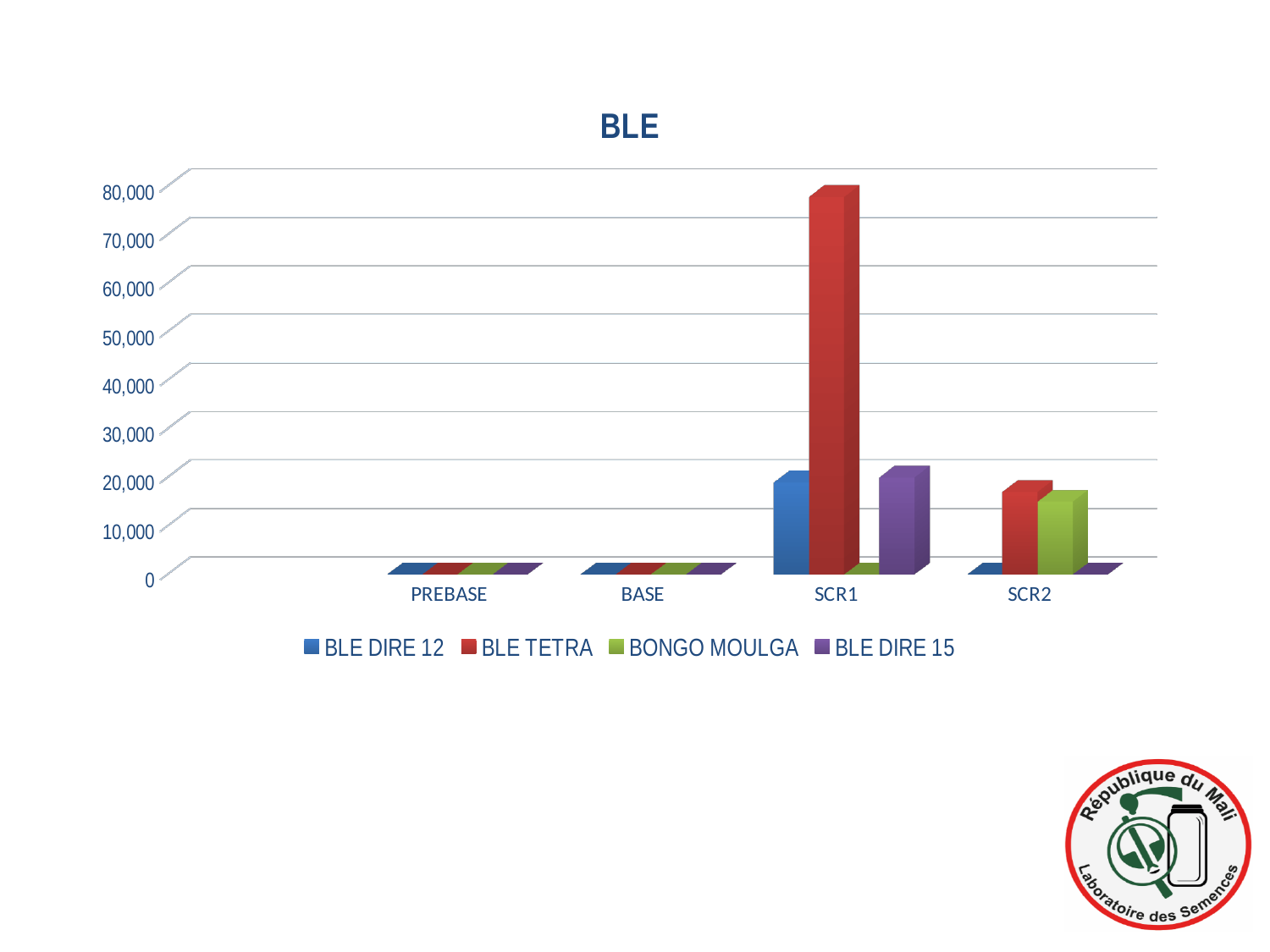
How many series does the legend of the chart list? 4 What colour represents the BLE TETRA series in the chart? Red What kind of chart is shown on the slide? Bar chart In which category does BLE TETRA reach its highest value? SCR1 How many categories are shown on the x axis of the chart? 4 Is the value for BONGO MOULGA at SCR2 greater or less than 20,000? less Is the value for BLE TETRA at SCR1 greater or less than 70,000? greater Which series has the tallest bar in the chart? BLE TETRA At SCR1, which is larger: the value for BLE TETRA or the value for BLE DIRE 12? BLE TETRA Is the value for BLE DIRE 12 at SCR1 greater or less than 10,000? greater What is the title of the chart? BLE